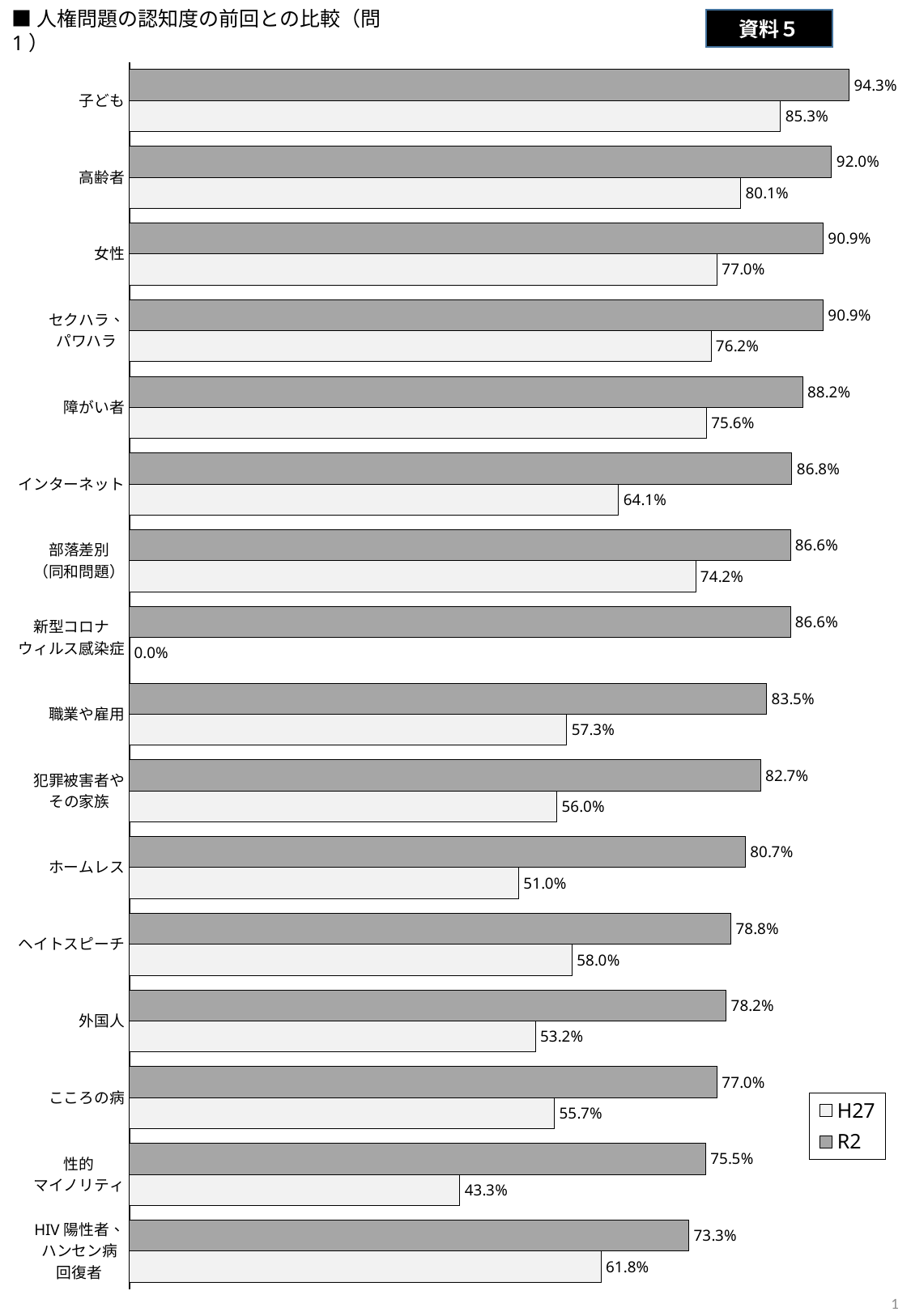
What is the H27 value for インターネット? 64.1% What type of chart is shown on the slide? Bar chart Which series is shown with the darker gray bars? R2 Which is larger, the H27 value for ヘイトスピーチ or the H27 value for 外国人? ヘイトスピーチ Which category has the highest R2 value? 子ども What is the H27 value for 新型コロナウィルス感染症? 0.0% What is the difference between the R2 and H27 values for 性的マイノリティ? 32.2% What is the R2 value for 子ども? 94.3% Which category has the lowest R2 value? HIV陽性者、ハンセン病回復者 How many series does the legend list? 2 How many categories are shown on the chart? 16 What is the R2 value for ホームレス? 80.7%